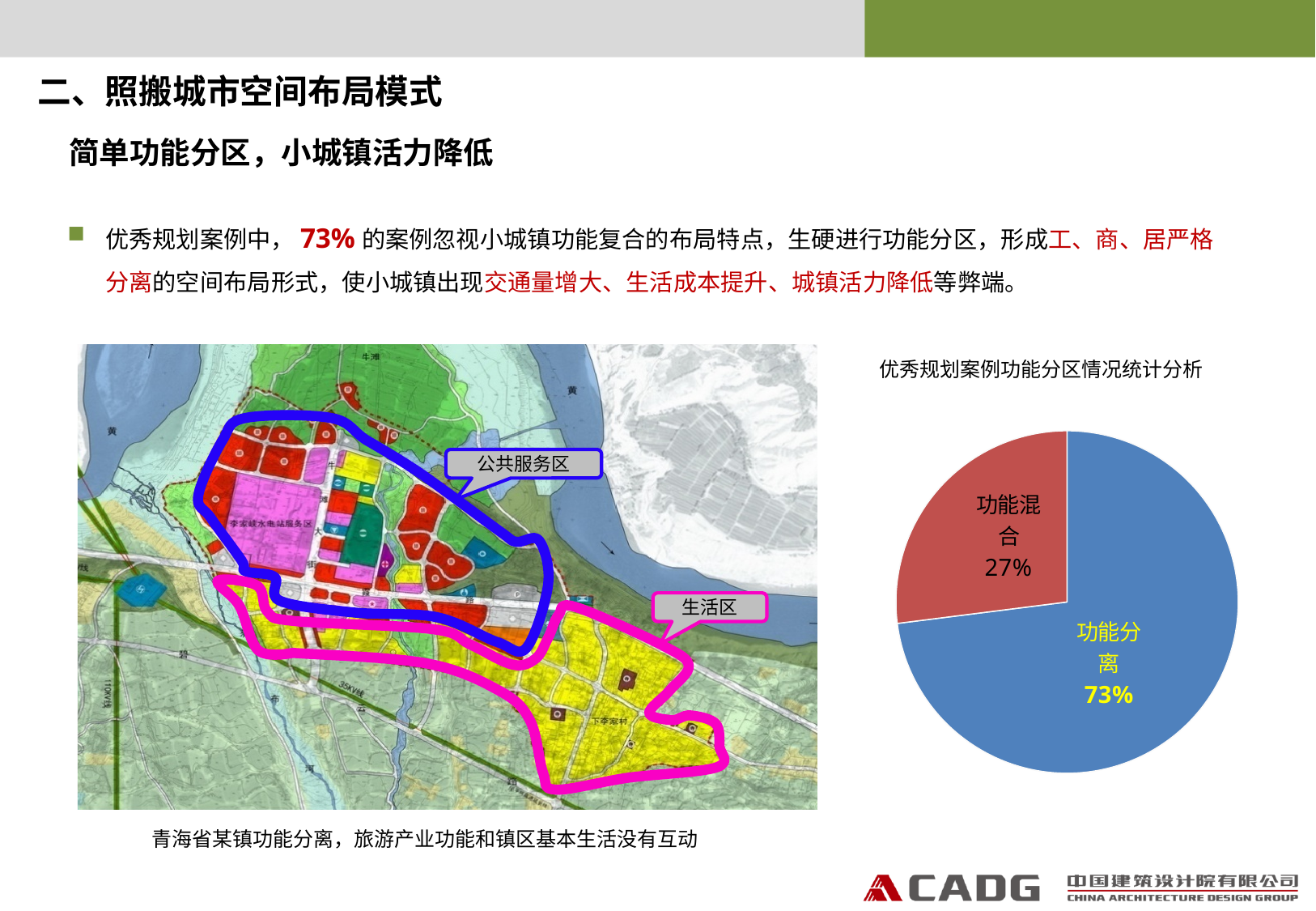
What colour is the 功能分离 slice of the pie chart? blue What is the title of the pie chart? 优秀规划案例功能分区情况统计分析 How many slices does the pie chart have? 2 In the pie chart, which is larger: 功能分离 or 功能混合? 功能分离 In the pie chart, what share is labelled for 功能分离? 73% What is the difference in percentage points between the 功能分离 and 功能混合 slices of the pie chart? 46 What kind of chart is shown under the title 优秀规划案例功能分区情况统计分析? pie chart Which slice of the pie chart is the largest? 功能分离 Which slice of the pie chart is the smallest? 功能混合 In the pie chart, what share is labelled for 功能混合? 27%